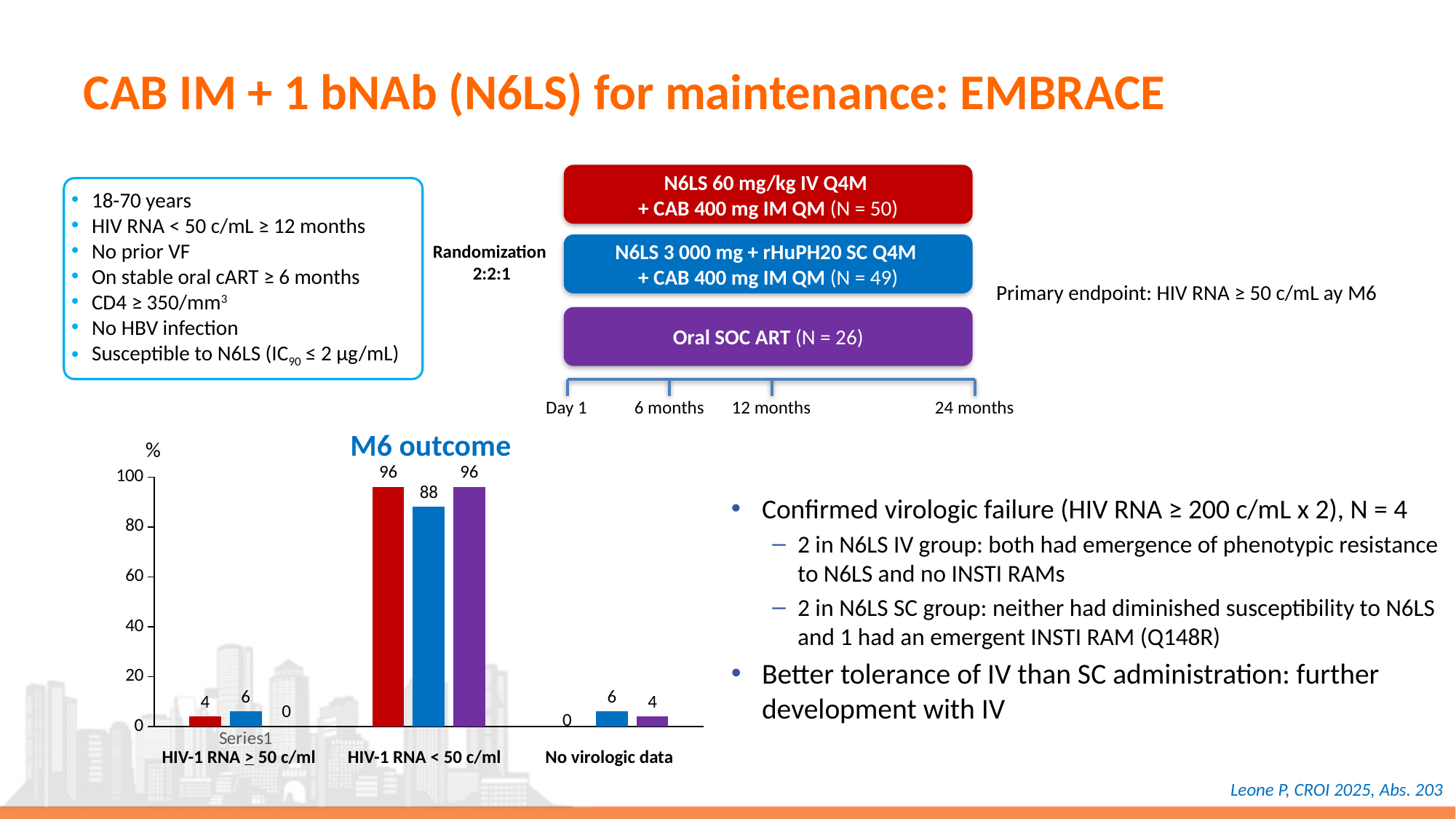
How many categories are shown on the x axis of the M6 outcome chart? 3 In the M6 outcome chart, which category has the highest values across all bars? HIV-1 RNA < 50 c/ml In the M6 outcome chart, what is the difference between the red bar and the blue bar for HIV-1 RNA < 50 c/ml? 8 In the M6 outcome chart, what is the value of the red bar for HIV-1 RNA < 50 c/ml? 96 In the M6 outcome chart, what is the value of the blue bar for No virologic data? 6 In the M6 outcome chart, is the value of the blue bar for HIV-1 RNA < 50 c/ml greater or less than 80? greater In the M6 outcome chart, what is the value of the purple bar for HIV-1 RNA ≥ 50 c/ml? 0 In the M6 outcome chart, which is larger for No virologic data: the blue bar or the purple bar? the blue bar What type of chart is the M6 outcome chart? bar chart What is the title of the bar chart on the slide? M6 outcome In the M6 outcome chart, what is the value of the blue bar for HIV-1 RNA < 50 c/ml? 88 In the M6 outcome chart, what is the value of the red bar for HIV-1 RNA ≥ 50 c/ml? 4